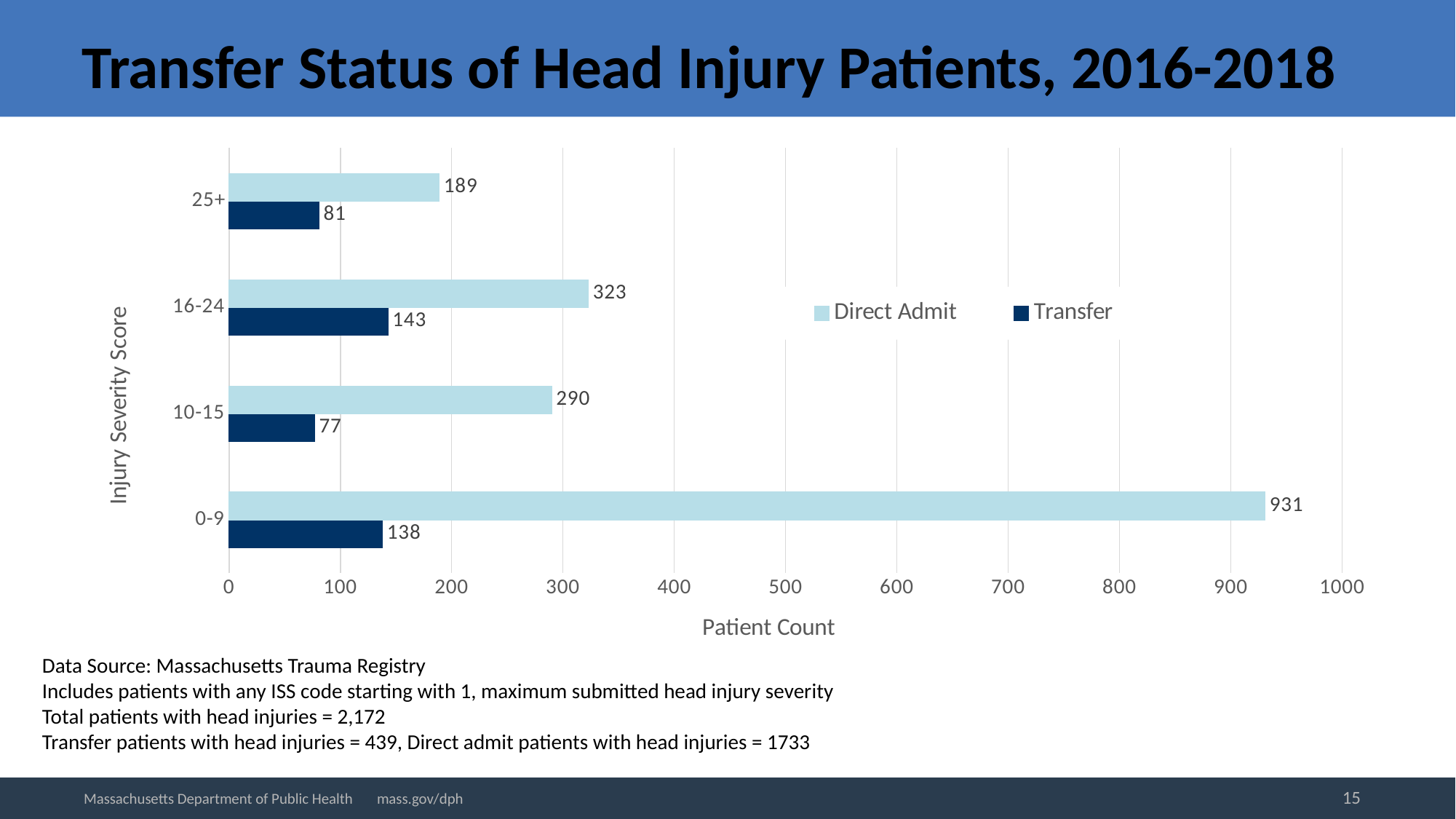
Which Injury Severity Score group has the lowest Transfer patient count? 10-15 What is the Transfer patient count for the 16-24 Injury Severity Score group? 143 What kind of chart is shown on the slide? Bar chart How many Injury Severity Score groups are shown on the chart? 4 What is the Transfer patient count for the 25+ Injury Severity Score group? 81 What is the label of the x axis? Patient Count Is the Direct Admit patient count for the 0-9 group greater or less than 900? greater How many series does the legend list? 2 What is the difference between the Direct Admit and Transfer patient counts for the 10-15 group? 213 Which is larger, the Direct Admit count for 16-24 or the Direct Admit count for 25+? Direct Admit count for 16-24 Which Injury Severity Score group has the highest Direct Admit patient count? 0-9 What is the Direct Admit patient count for the 0-9 Injury Severity Score group? 931